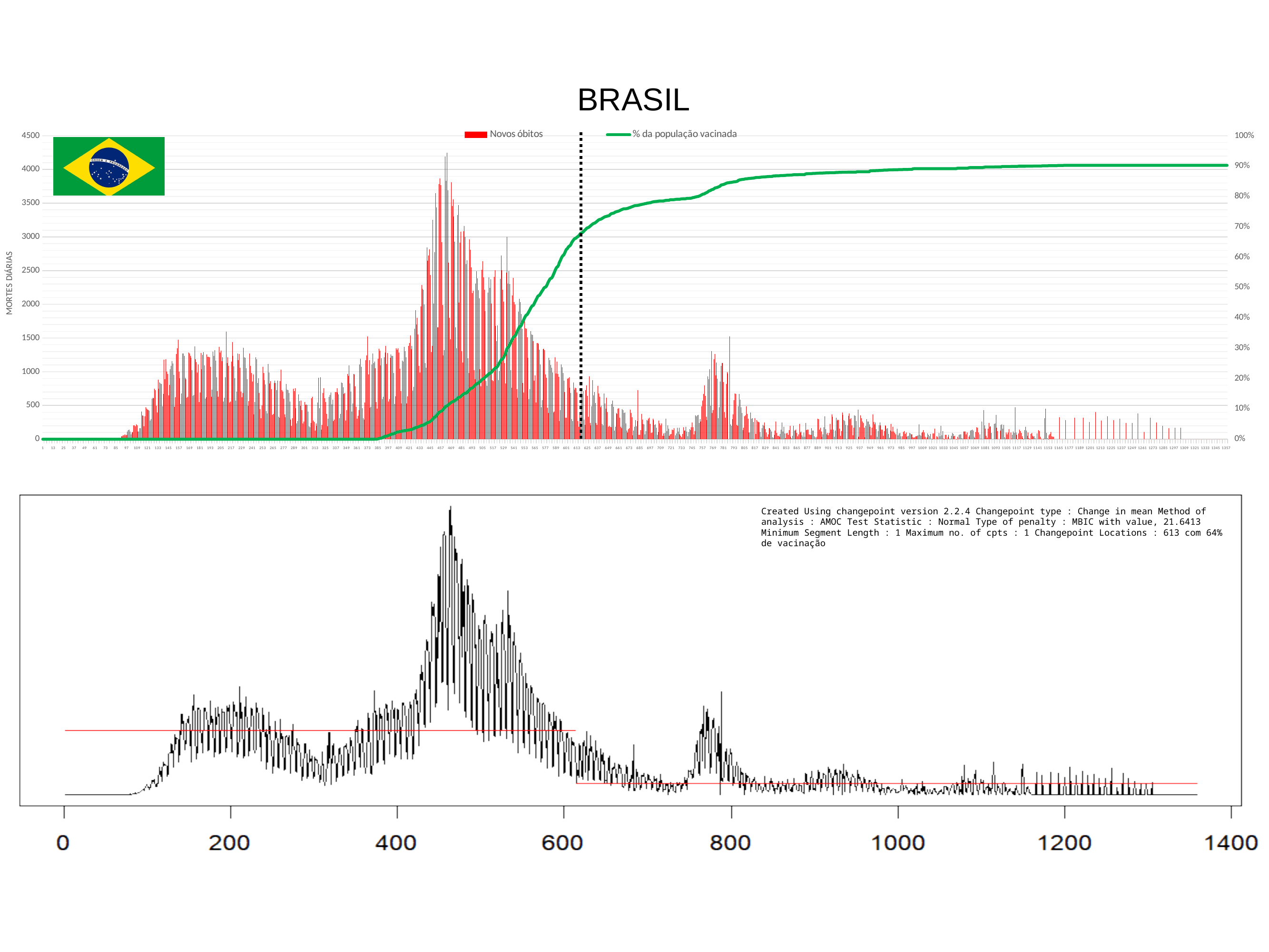
In the top chart, is the Novos óbitos peak around day 469 larger or smaller than the peak around day 205? larger In the top chart, what kind of chart is used to plot Novos óbitos? bar chart In the top chart, is the highest Novos óbitos value greater or less than 4000? greater In the bottom chart, does the red mean level rise or fall after the changepoint? falls In the top chart, does the % da população vacinada line rise or fall along the x axis? rises In the top chart, is the peak of Novos óbitos around day 769 greater or less than 1000? greater In the top chart, is the % da população vacinada at the dotted vertical line greater or less than 60%? greater What is the title of the top chart? BRASIL According to the annotation on the bottom chart, what is the changepoint location? 613 How many series does the legend of the top chart list? 2